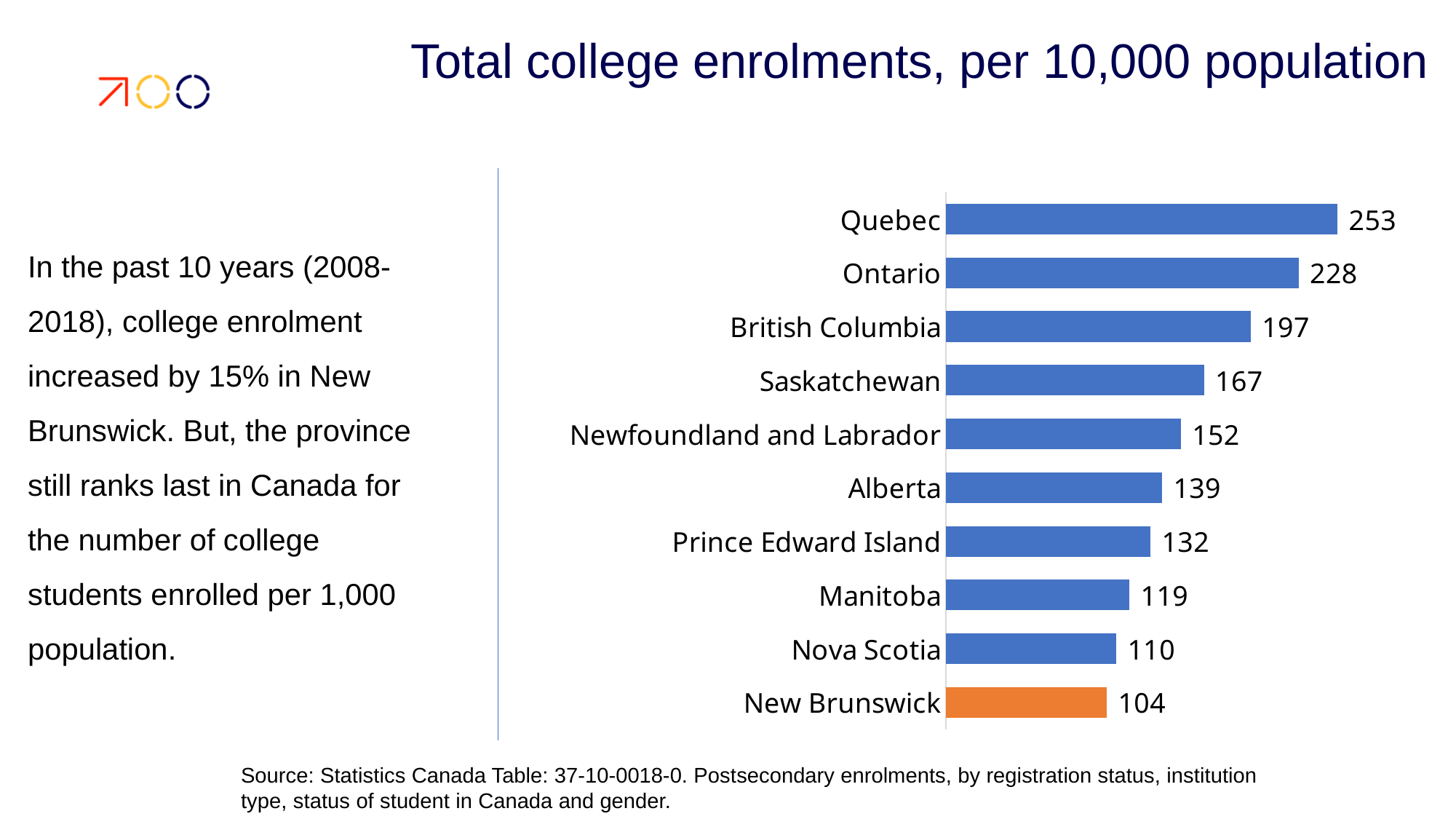
What kind of chart is shown on the slide? Bar chart What is the value for Newfoundland and Labrador? 152 How many provinces are shown in the chart? 10 What is the value for Quebec? 253 Which province has the highest value? Quebec What is the value for New Brunswick? 104 Which province's bar is coloured orange instead of blue? New Brunswick What is the difference between the values for Quebec and Ontario? 25 Which is larger, the value for Saskatchewan or the value for Alberta? Saskatchewan What is the difference between the values for Nova Scotia and New Brunswick? 6 Which province has the lowest value? New Brunswick What is the title of the chart? Total college enrolments, per 10,000 population